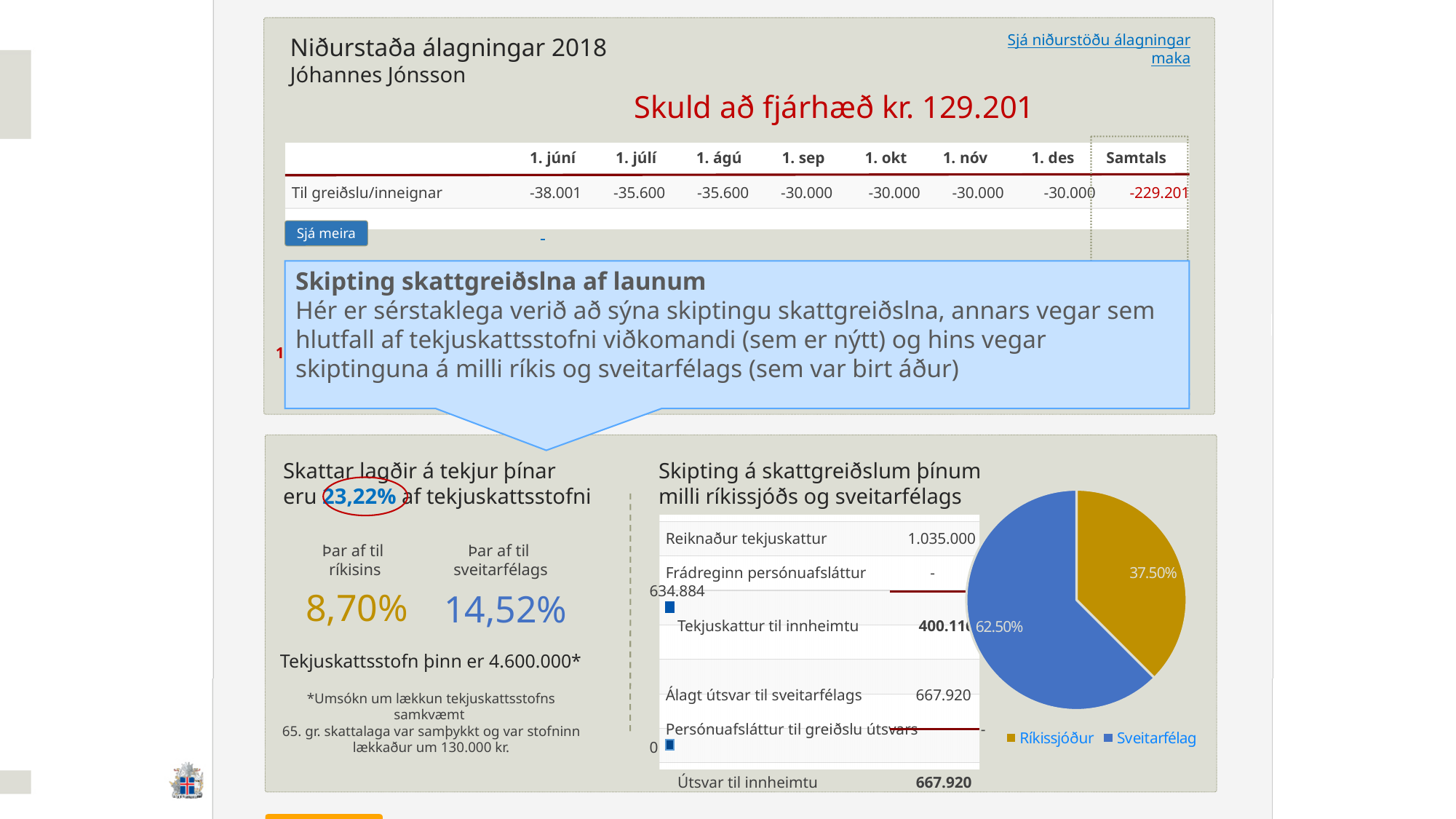
What kind of chart is shown on the slide? pie chart What is the difference in percentage points between the Sveitarfélag and Ríkissjóður slices? 25.00% How many entries does the pie chart's legend list? 2 Is the share for Ríkissjóður greater or less than 50%? less What share of the pie chart does Ríkissjóður have? 37.50% What share of the pie chart does Sveitarfélag have? 62.50% Which slice of the pie chart is the largest? Sveitarfélag What colour is the Ríkissjóður slice in the pie chart? gold Which slice of the pie chart is the smallest? Ríkissjóður How many slices does the pie chart have? 2 Which is larger in the pie chart, Ríkissjóður or Sveitarfélag? Sveitarfélag What colour is the Sveitarfélag slice in the pie chart? blue